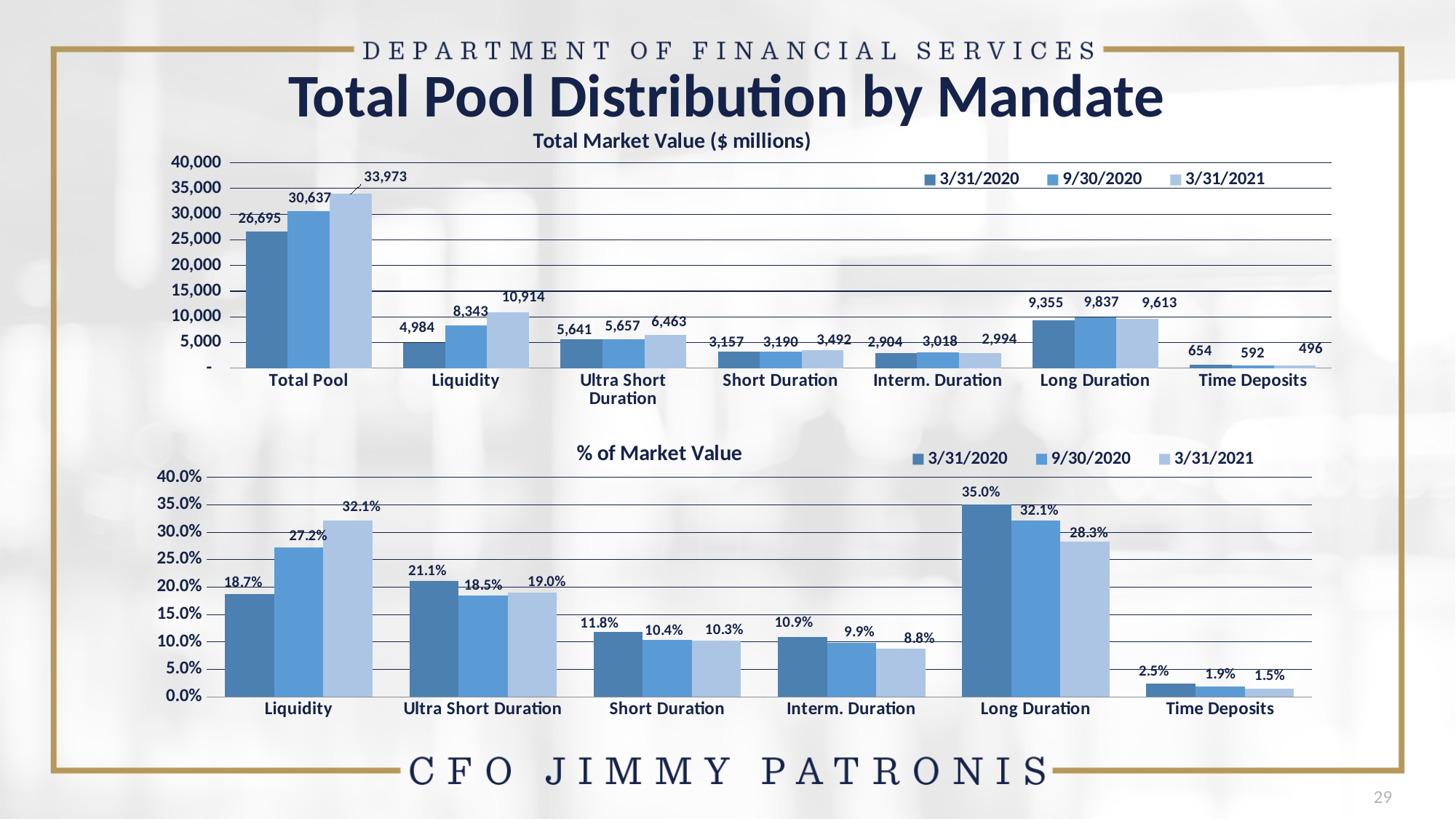
In the '% of Market Value' chart, what is the value for Interm. Duration on 3/31/2021? 8.8% In the 'Total Market Value ($ millions)' chart, what is the value for Total Pool on 3/31/2021? 33,973 In the 'Total Market Value ($ millions)' chart, what is the difference between the Total Pool values on 3/31/2021 and 3/31/2020? 7,278 In the '% of Market Value' chart, does the Liquidity share rise or fall from 3/31/2020 to 3/31/2021? rise In the 'Total Market Value ($ millions)' chart, how many categories are shown on the x axis? 7 In the 'Total Market Value ($ millions)' chart, which category has the lowest value on 3/31/2020? Time Deposits In the '% of Market Value' chart, which is larger on 9/30/2020: Short Duration or Interm. Duration? Short Duration In the 'Total Market Value ($ millions)' chart, how many series does the legend list? 3 In the 'Total Market Value ($ millions)' chart, what is the value for Liquidity on 9/30/2020? 8,343 What kind of chart is the '% of Market Value' chart? bar chart In the 'Total Market Value ($ millions)' chart, which category other than Total Pool has the highest value on 3/31/2021? Liquidity In the '% of Market Value' chart, what is the value for Long Duration on 3/31/2020? 35.0%